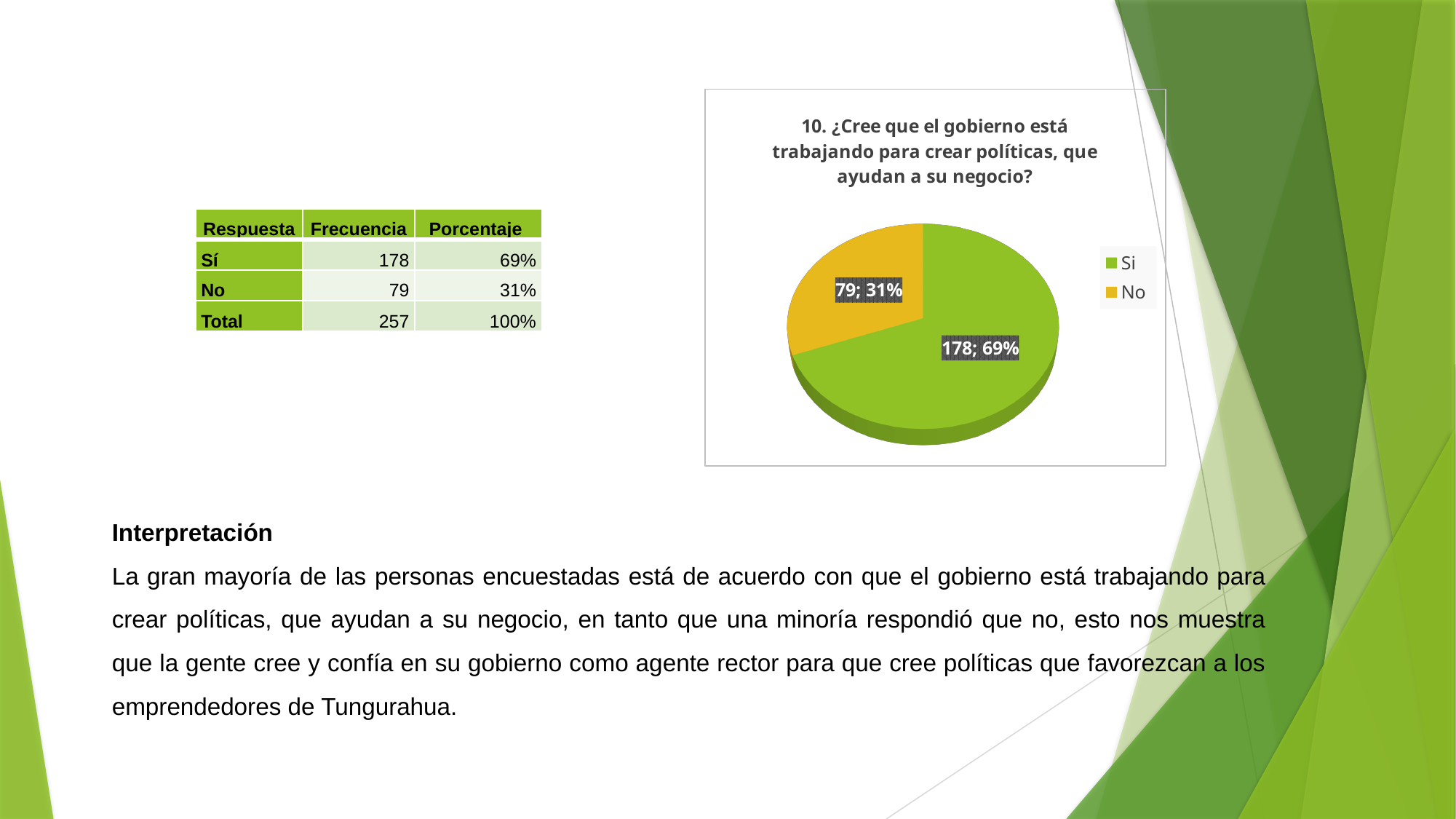
What percentage of the pie does the 'No' slice represent? 31% What is the frequency value shown for the 'Si' slice of the pie chart? 178 What is the title of the pie chart? 10. ¿Cree que el gobierno está trabajando para crear políticas, que ayudan a su negocio? Which slice of the pie chart is the largest? Si What is the difference between the 'Si' and 'No' frequency values in the pie chart? 99 How many slices does the pie chart have? 2 Which is larger in the pie chart, the value for 'Si' or the value for 'No'? Si What percentage of the pie does the 'Si' slice represent? 69% How many entries does the legend of the pie chart list? 2 What kind of chart is shown on the slide? pie chart What is the frequency value shown for the 'No' slice of the pie chart? 79 Which slice of the pie chart is the smallest? No